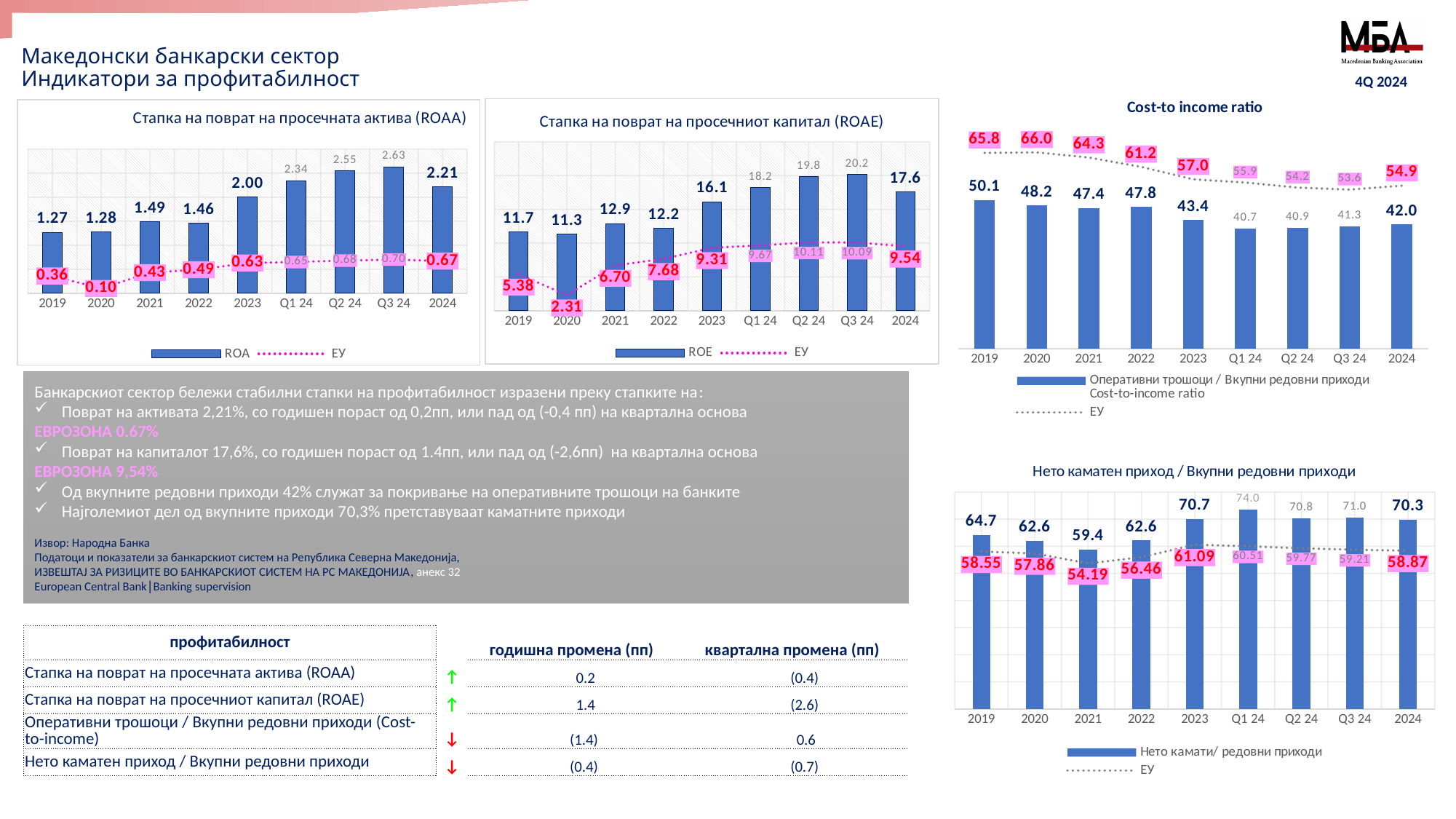
In the Cost-to income ratio chart, what is the bar value for 2019? 50.1 In the ROAA chart (Стапка на поврат на просечната актива), what is the ROA value for 2024? 2.21 In the ROAE chart (Стапка на поврат на просечниот капитал), what is the ROE value for 2023? 16.1 In the Cost-to income ratio chart, is the EU (ЕУ) value for 2020 larger or smaller than the EU value for 2024? larger In the chart titled 'Нето каматен приход / Вкупни редовни приходи', how many periods are shown on the x axis? 9 In the ROAA chart, which period has the highest ROA value? Q3 24 In the chart titled 'Нето каматен приход / Вкупни редовни приходи', what is the bar value for 2021? 59.4 In the ROAE chart, what is the difference between the ROE value for Q3 24 and the ROE value for 2024? 2.6 In the ROAE chart, which period has the lowest EU (ЕУ) value? 2020 In the Cost-to income ratio chart, which period has the lowest bar value? Q1 24 What type of chart is the Cost-to income ratio chart? Bar chart with a dotted line In the ROAA chart, what is the EU (ЕУ) value for 2020? 0.10